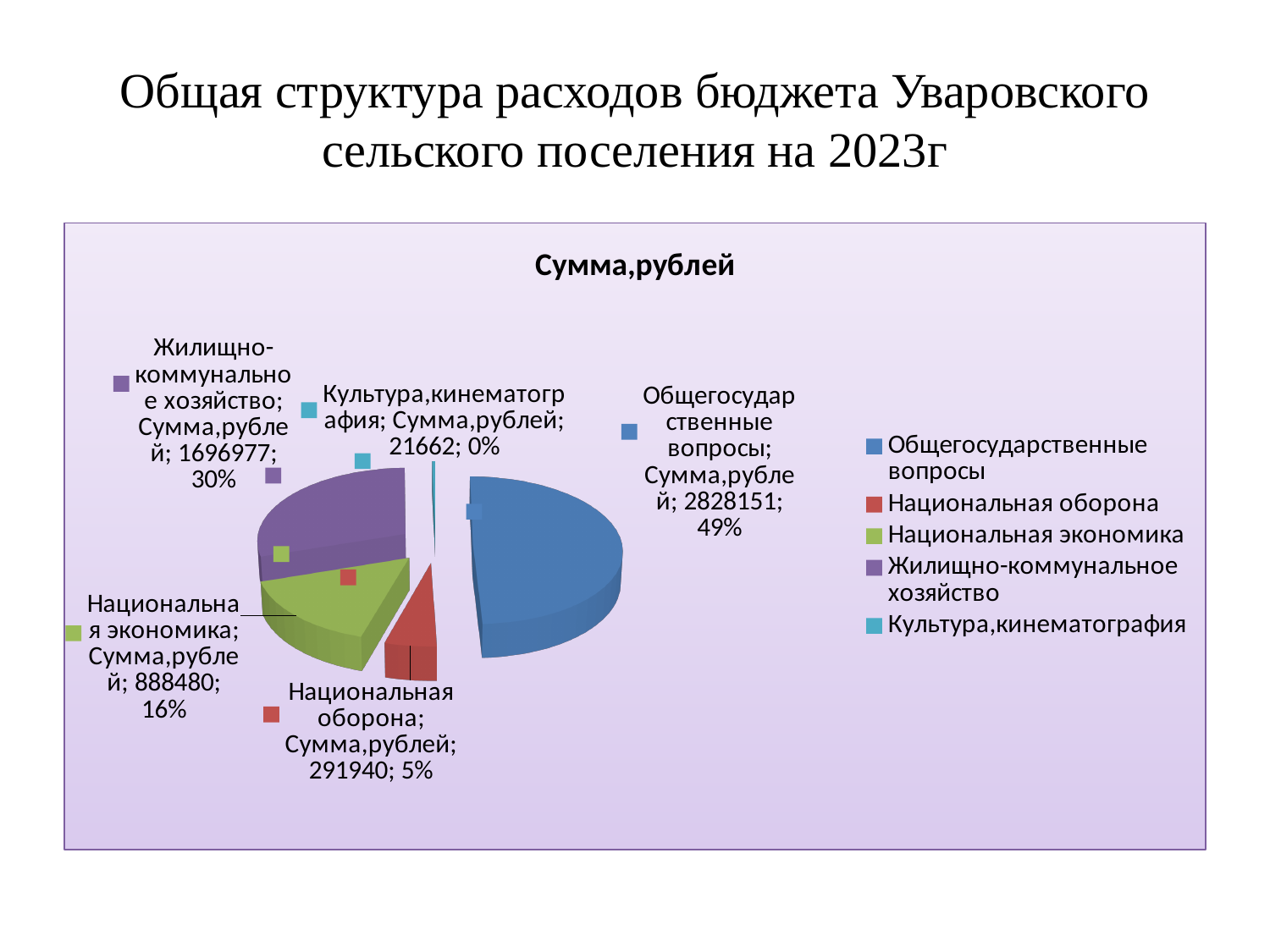
What is the difference between the values for Общегосударственные вопросы and Жилищно-коммунальное хозяйство? 1131174 What is the value for Общегосударственные вопросы? 2828151 Which is larger, the value for Национальная экономика or the value for Национальная оборона? Национальная экономика What share of the pie does Национальная экономика represent? 16% What share of the pie does Общегосударственные вопросы represent? 49% What is the value for Жилищно-коммунальное хозяйство? 1696977 What is the value for Культура,кинематография? 21662 What is the value for Национальная оборона? 291940 Which category has the largest slice? Общегосударственные вопросы How many categories does the legend list? 5 What type of chart is shown on the slide? pie chart Which category has the smallest slice? Культура,кинематография